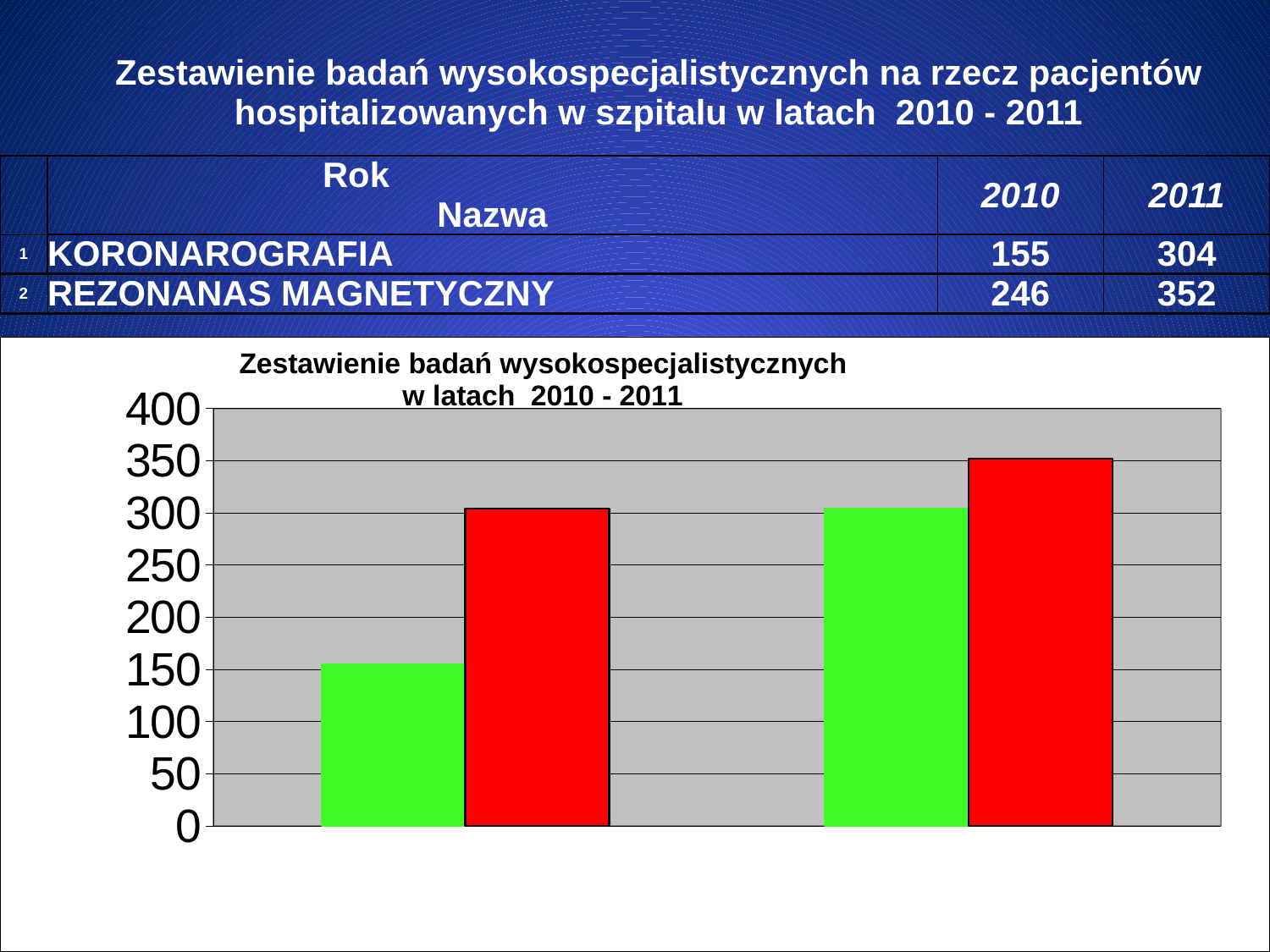
What is the title of the chart? Zestawienie badań wysokospecjalistycznych w latach 2010 - 2011 Is the value of the red bar in the left group greater or less than 250? greater What kind of chart is shown on the slide? bar chart In the left group of bars, which is taller, the green bar or the red bar? the red bar Which bar in the chart is the tallest? the rightmost red bar Is the value of the green bar in the right group greater or less than 250? greater What is the highest value shown on the vertical axis of the chart? 400 In the right group of bars, which is taller, the green bar or the red bar? the red bar Which bar in the chart is the shortest? the leftmost green bar Is the value of the leftmost green bar greater or less than 200? less How many bars are plotted in the chart? 4